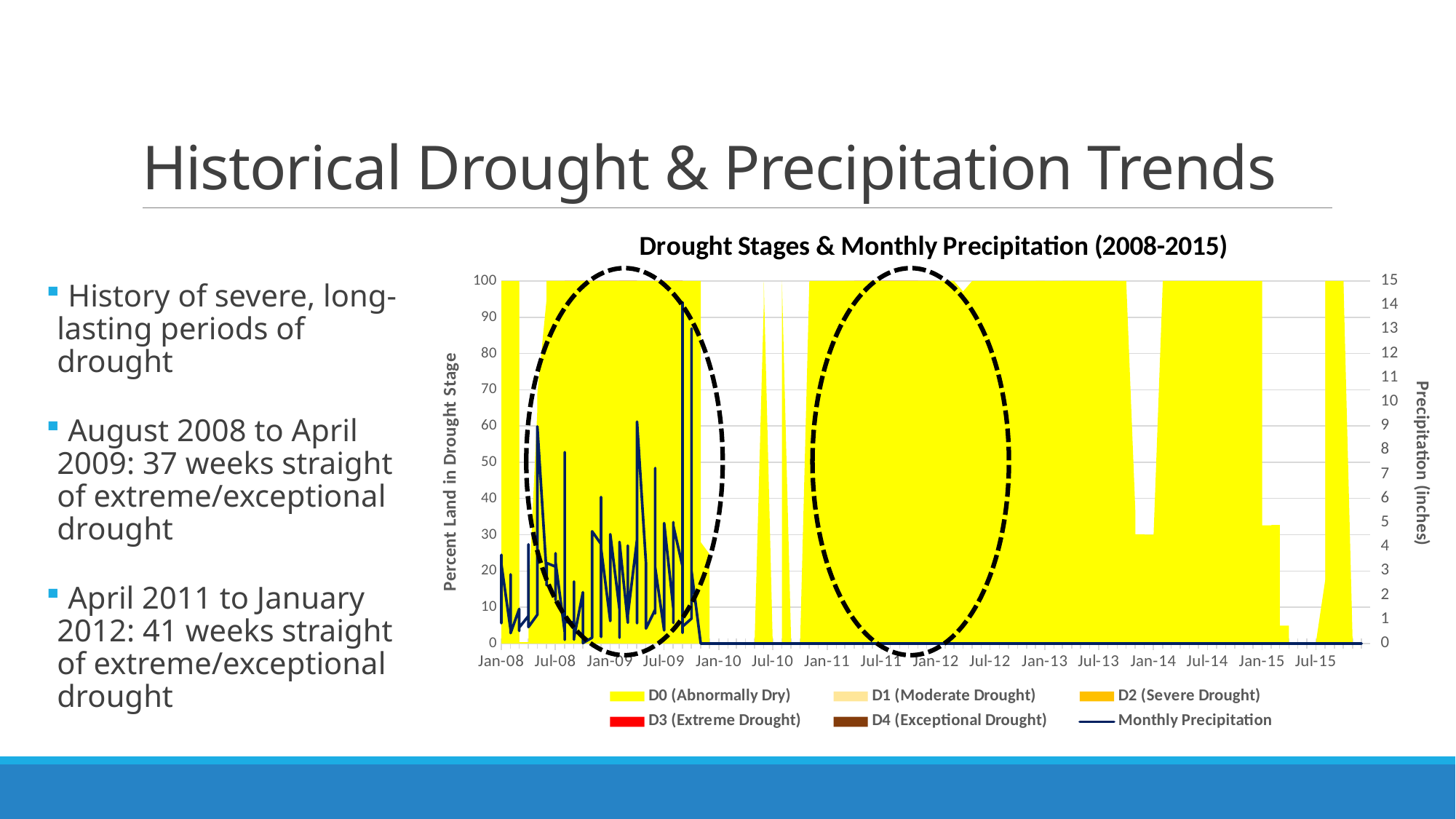
Is the D0 (Abnormally Dry) value at Jan-14 greater or less than 50 percent? less How many series does the chart's legend list? 6 Is the peak Monthly Precipitation value in late 2009 greater or less than 10 inches? greater What is the highest value shown on the right vertical axis (Precipitation)? 15 Is the D0 (Abnormally Dry) value at Jul-11 greater or less than 50 percent? greater What is the first date label on the x axis of the chart? Jan-08 What is the label of the right-hand vertical axis of the chart? Precipitation (inches) What is the highest value shown on the left vertical axis (Percent Land in Drought Stage)? 100 What is the title of the chart on the slide? Drought Stages & Monthly Precipitation (2008-2015) Which series is plotted as a line rather than a filled area in the chart? Monthly Precipitation How many date labels are shown along the x axis of the chart? 16